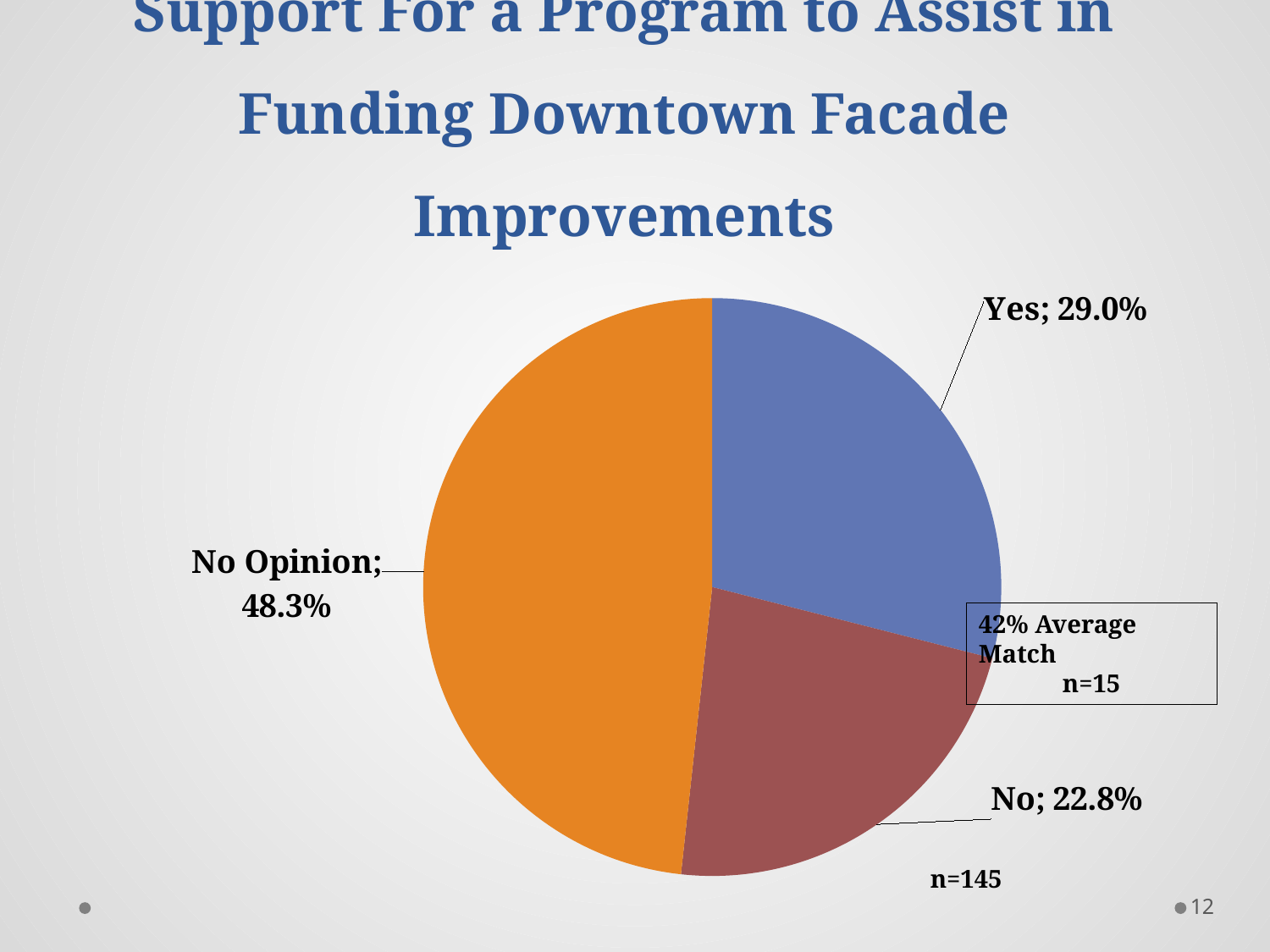
Which is larger, the Yes slice or the No slice? Yes What percentage of respondents had No Opinion? 48.3% Which response category has the smallest share of the pie? No What colour is the No Opinion slice? Orange What is the difference in percentage points between the Yes and No slices? 6.2 What kind of chart is shown on the slide? Pie chart What is the sample size (n) shown for the chart? n=145 How many slices does the pie chart have? 3 What percentage of respondents answered No? 22.8% What is the difference in percentage points between the No Opinion and Yes slices? 19.3 Which response category has the largest share of the pie? No Opinion What percentage of respondents answered Yes? 29.0%